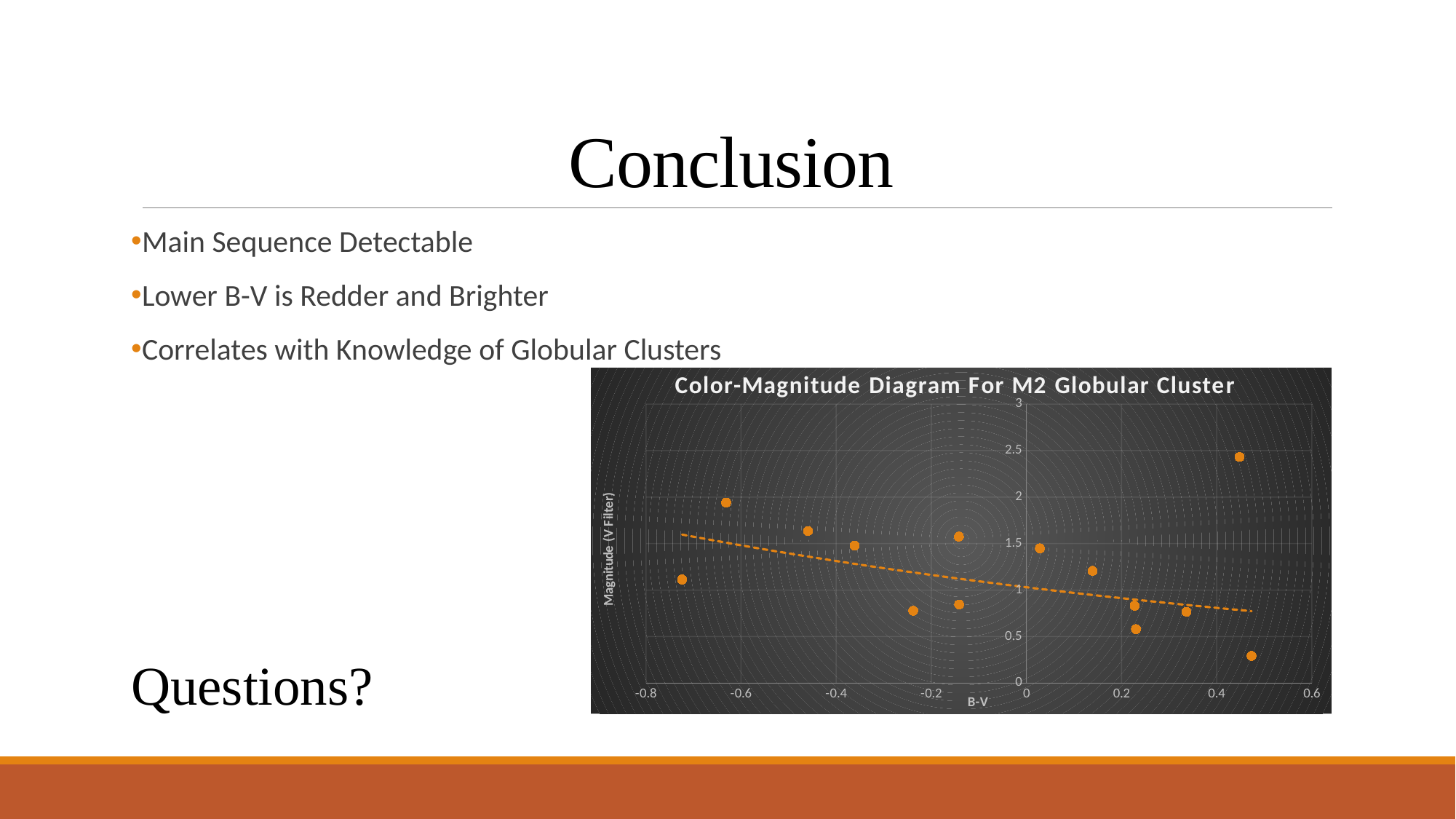
Is the magnitude of the leftmost point (near B-V -0.7) greater or less than 1.5? less What is the highest value shown on the y axis of the chart? 3 Which has the higher magnitude: the point near B-V -0.63 or the point near B-V -0.72? The point near B-V -0.63 How many data points are plotted on the chart? 14 What is the title of the chart? Color-Magnitude Diagram For M2 Globular Cluster Is the magnitude of the lowest point (near B-V 0.47) greater or less than 0.5? less What kind of chart is shown on the slide? Scatter chart Is the magnitude of the point near B-V 0.45 at the top right greater or less than 2? greater What is the label of the x axis of the chart? B-V Does the dashed trend line rise or fall as B-V increases? Falls